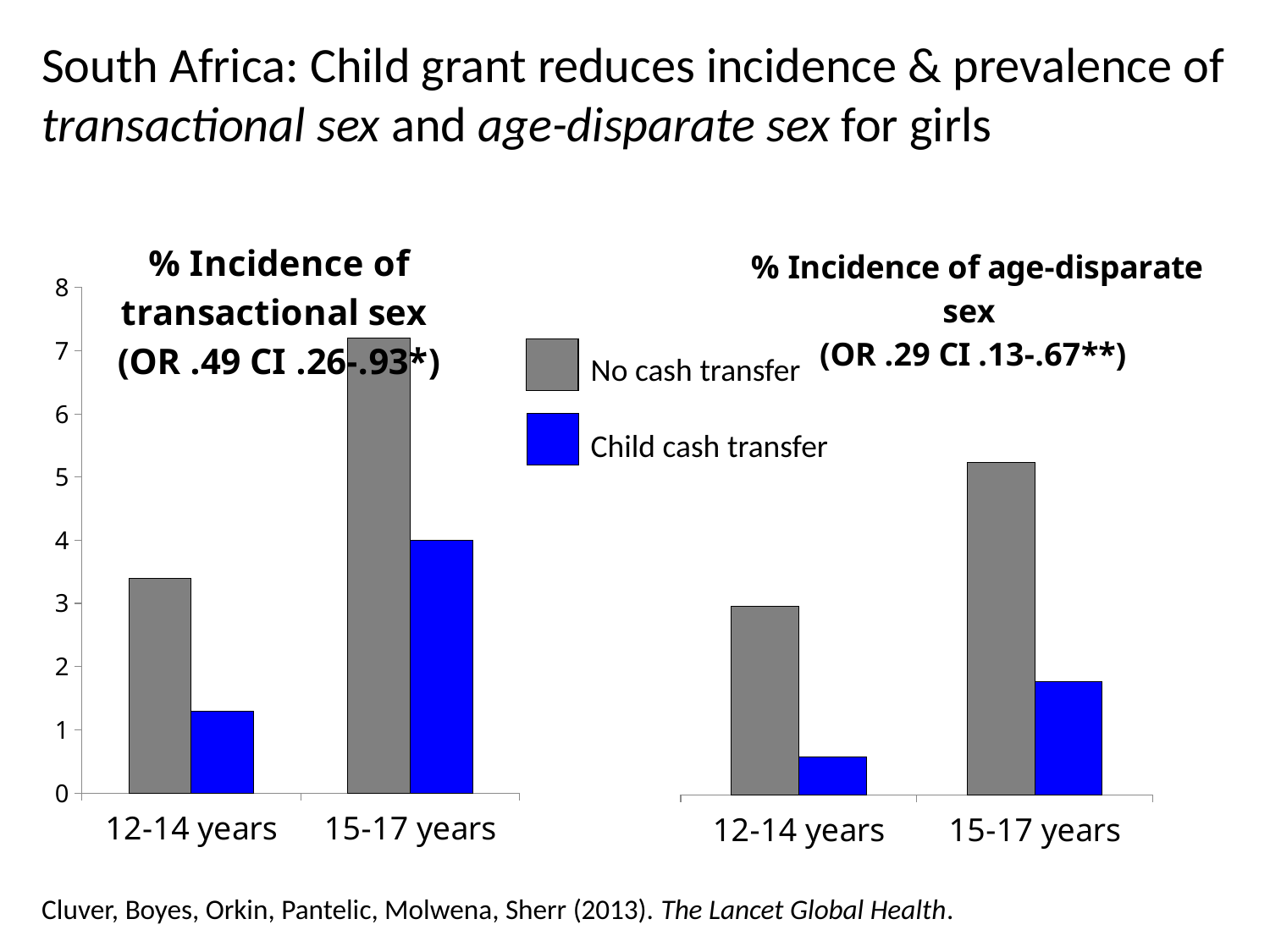
In the '% Incidence of age-disparate sex' chart, for 12-14 years, which is larger: No cash transfer or Child cash transfer? No cash transfer In the '% Incidence of age-disparate sex' chart, which bar is the tallest? No cash transfer, 15-17 years In the '% Incidence of transactional sex' chart, which bar is the tallest? No cash transfer, 15-17 years How many series does the legend list? 2 In the '% Incidence of transactional sex' chart, is the value for No cash transfer at 15-17 years greater or less than 6? greater What kind of chart is the '% Incidence of transactional sex' chart on the left? Bar chart What colour represents the Child cash transfer series in the legend? Blue In the '% Incidence of transactional sex' chart, how many age-group categories are shown on the x axis? 2 In the '% Incidence of transactional sex' chart, does the No cash transfer value rise or fall from 12-14 years to 15-17 years? rise In the '% Incidence of transactional sex' chart, which bar is the shortest? Child cash transfer, 12-14 years In the '% Incidence of transactional sex' chart, for 15-17 years, which is larger: No cash transfer or Child cash transfer? No cash transfer In the '% Incidence of transactional sex' chart, is the value for Child cash transfer at 12-14 years greater or less than 2? less